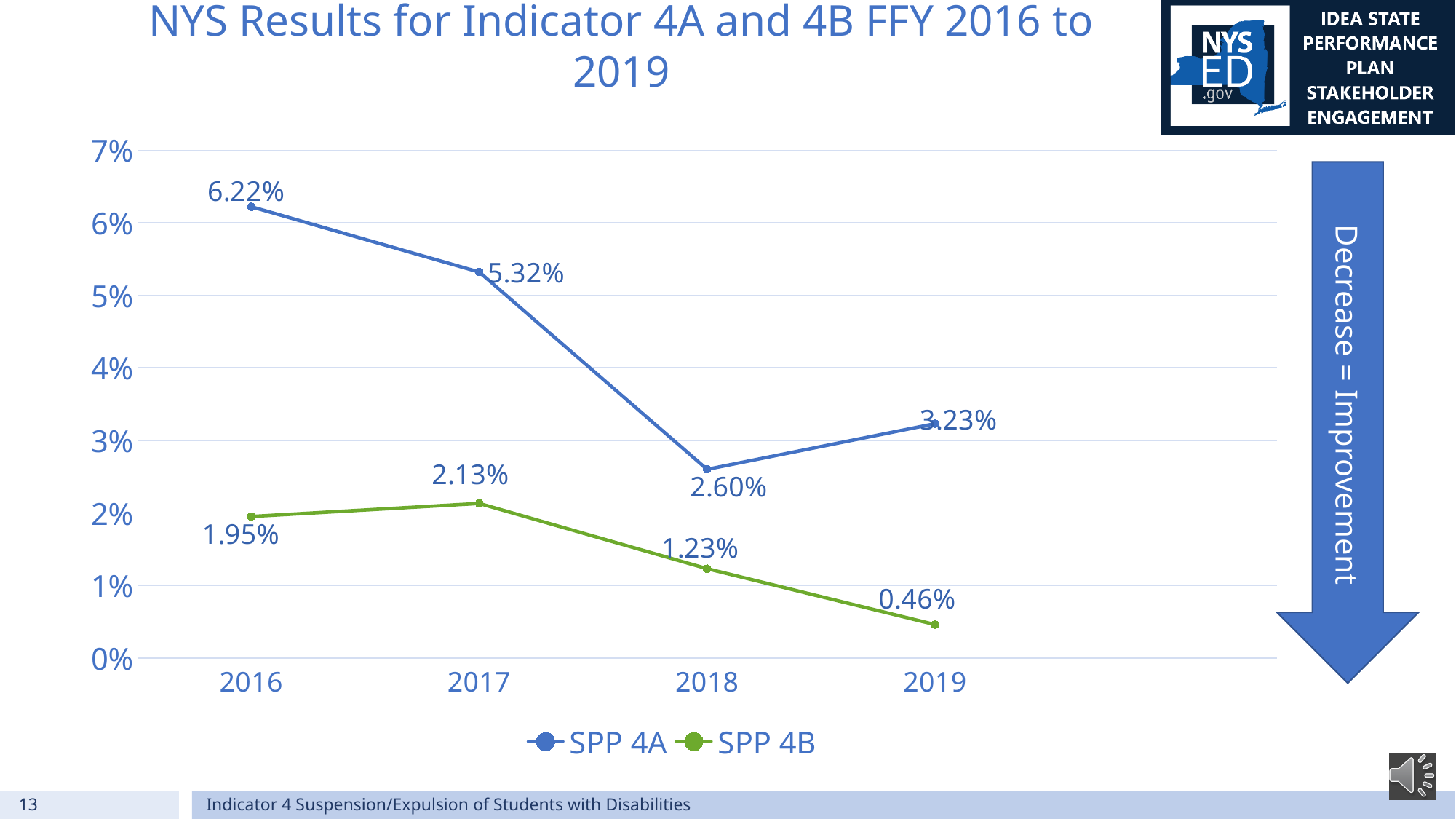
How many series does the legend list? 2 Which is larger in 2018, SPP 4A or SPP 4B? SPP 4A What is the SPP 4A value for 2016? 6.22% In which year is SPP 4A highest? 2016 What is the SPP 4B value for 2017? 2.13% In which year is SPP 4B lowest? 2019 Does SPP 4B rise or fall from 2017 to 2019? Fall What is the SPP 4B value for 2019? 0.46% What is the SPP 4A value for 2018? 2.60% What is the difference between the SPP 4A values for 2016 and 2017? 0.90% How many years are shown on the x axis? 4 What kind of chart is shown on the slide? Line chart